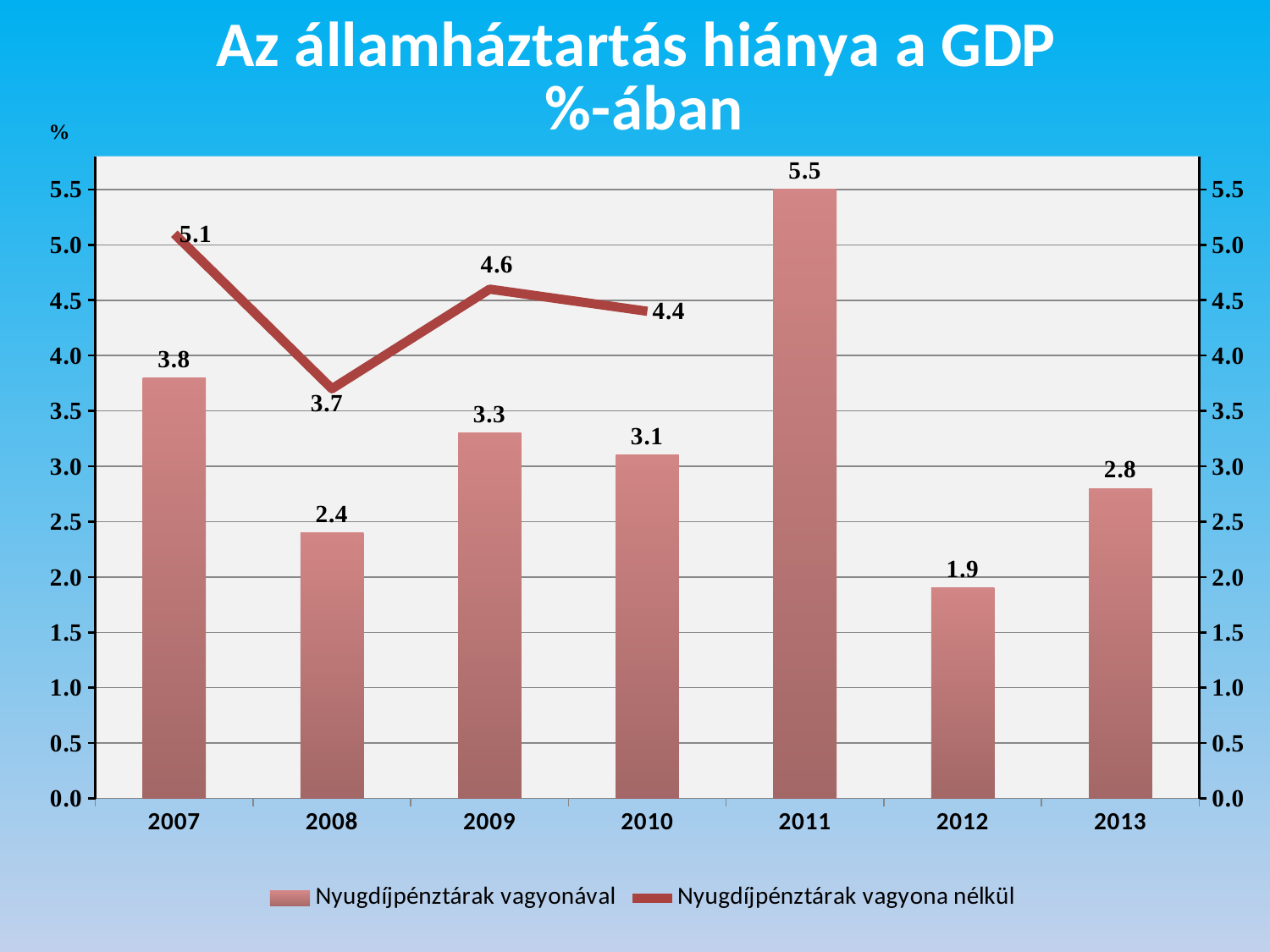
Which is larger: the 'Nyugdíjpénztárak vagyonával' value for 2009 or for 2010? 2009 What is the value of the 'Nyugdíjpénztárak vagyonával' bar for 2013? 2.8 What kind of chart is shown on the slide? Combined bar and line chart What is the value of the 'Nyugdíjpénztárak vagyonával' bar for 2011? 5.5 What is the value of the 'Nyugdíjpénztárak vagyona nélkül' line for 2008? 3.7 Does the 'Nyugdíjpénztárak vagyonával' series rise or fall from 2011 to 2012? Fall Which year has the highest 'Nyugdíjpénztárak vagyonával' bar? 2011 Which year has the lowest 'Nyugdíjpénztárak vagyonával' bar? 2012 How many series does the legend list? 2 What is the title of the chart? Az államháztartás hiánya a GDP %-ában How many years are shown on the x axis? 7 What is the difference between the 'Nyugdíjpénztárak vagyona nélkül' value and the 'Nyugdíjpénztárak vagyonával' value in 2007? 1.3